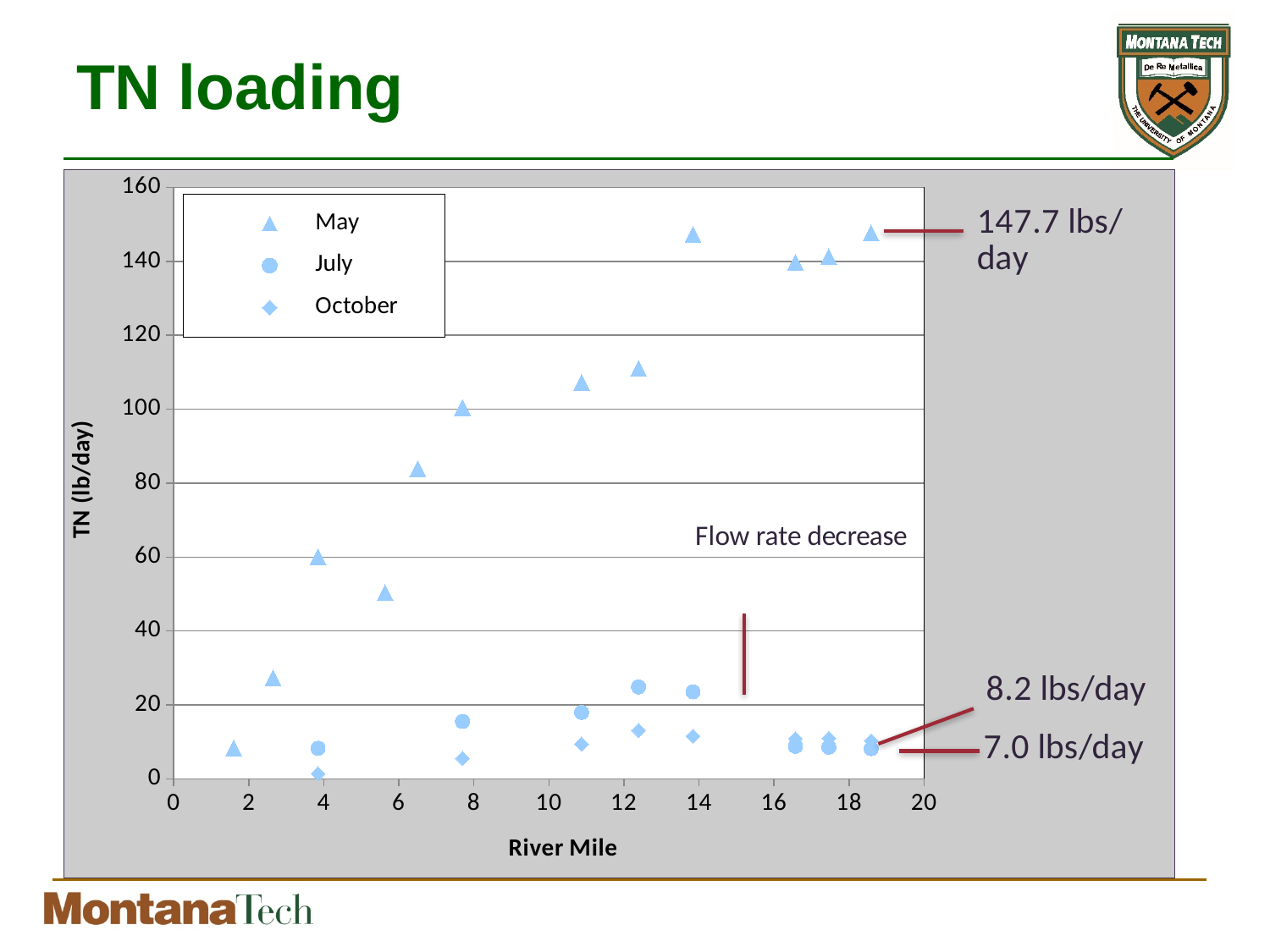
What is the annotated TN loading for the highest May point near river mile 18.6? 147.7 lbs/day At about river mile 8, which series has the larger value, July or October? July At about river mile 12, which series has the larger value, May or July? May What is the title of the y axis? TN (lb/day) Is the May value at about river mile 14 greater or less than 140? greater Do the May values generally rise or fall as river mile increases? rise How many series does the legend list? 3 Is the May value at about river mile 5.6 greater or less than 60? less Which series has the highest TN loading values? May What kind of chart is shown on the slide? scatter chart Which series are listed in the legend? May, July, October Are the July values greater or less than 40 across all river miles? less